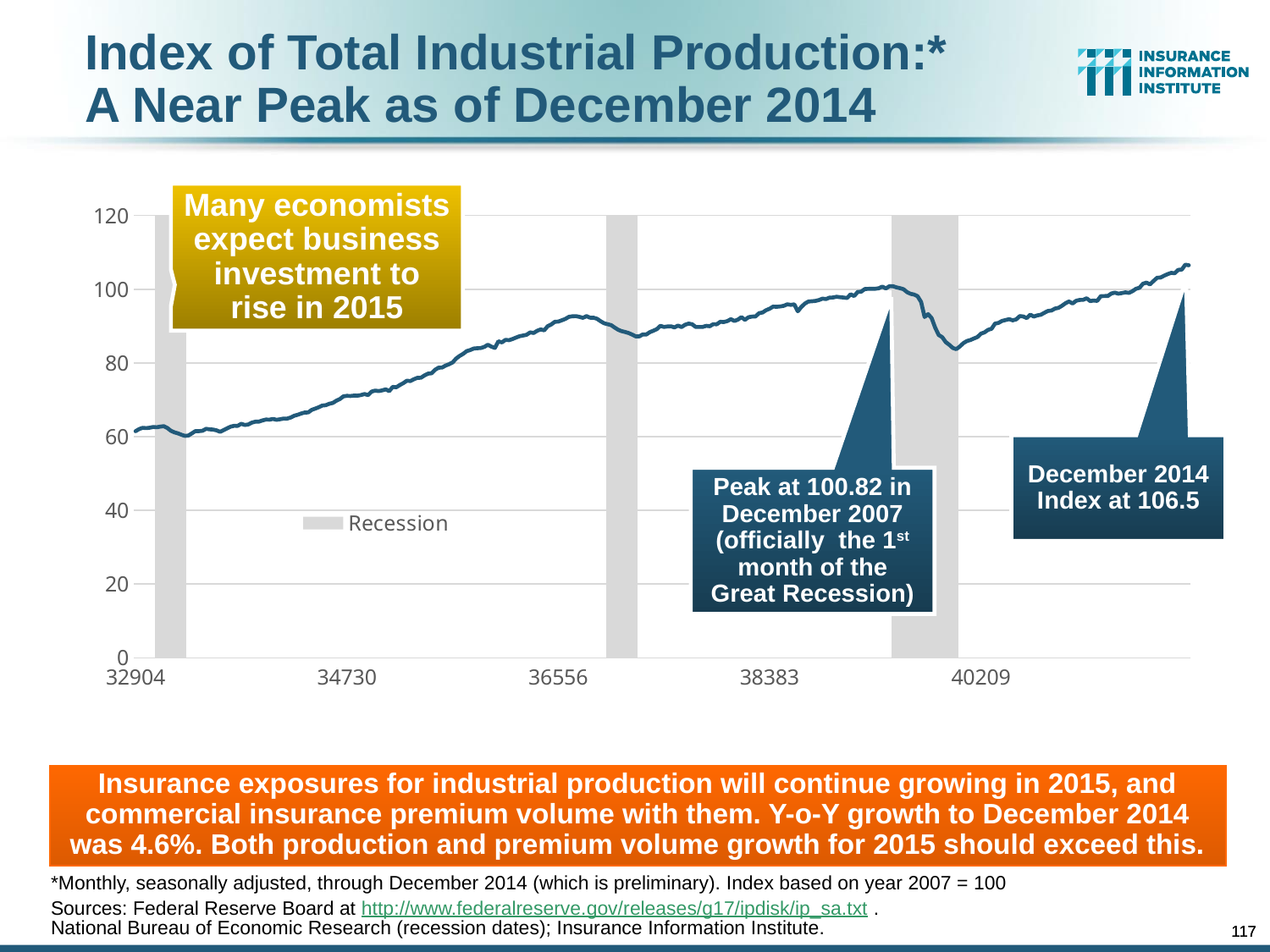
Is the index value in December 2014 greater or less than 100? greater What is the value of the Index of Total Industrial Production in December 2014? 106.5 Which is higher: the index in December 2014 or the peak in December 2007? December 2014 What kind of chart is shown on the slide? line chart By how much does the December 2014 index value exceed the December 2007 peak? 5.68 Is the index value at the low point just after the December 2007 peak greater or less than 100? less Is the index value at the start of the series (left end of the line) greater or less than 80? less What does the gray shading on the chart represent, according to the legend? Recession How many shaded recession periods are shown on the chart? 3 Over the whole period shown, does the index generally rise or fall along the x axis? rise What was the peak value of the index in December 2007? 100.82 What is the highest value labeled on the y axis of the chart? 120